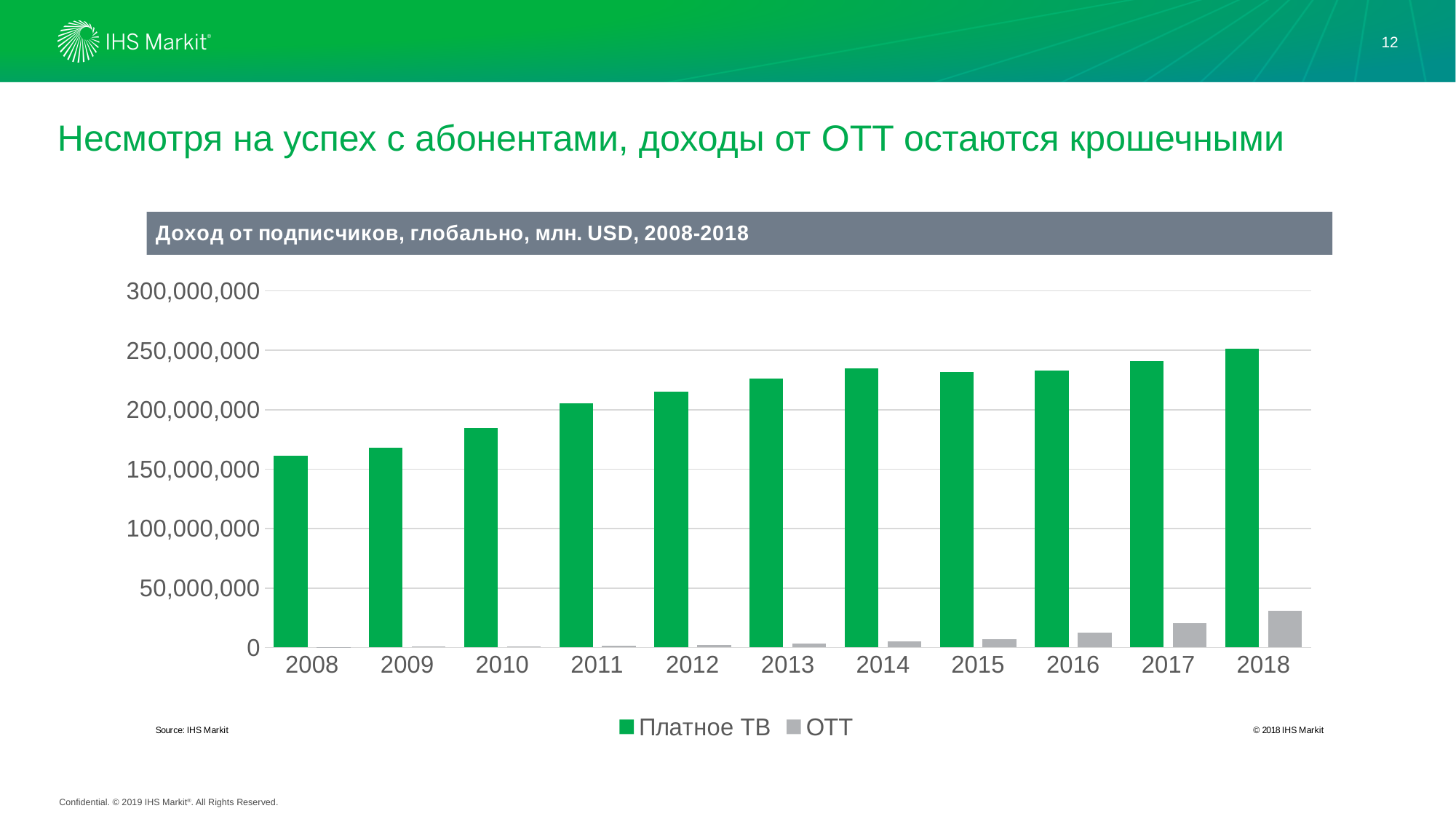
Is the Платное ТВ value for 2008 greater or less than 150,000,000? greater Is the Платное ТВ value for 2010 greater or less than 200,000,000? less In which year is the Платное ТВ value lowest? 2008 Do the OTT values rise or fall from 2008 to 2018? rise What kind of chart is shown on the slide? bar chart Which is larger, the Платное ТВ value for 2008 or for 2018? 2018 In which year is the OTT value highest? 2018 How many years are shown on the x axis? 11 How many series does the legend list? 2 In which year is the Платное ТВ value highest? 2018 What is the title of the chart? Доход от подписчиков, глобально, млн. USD, 2008-2018 Is the OTT value for 2018 greater or less than 50,000,000? less